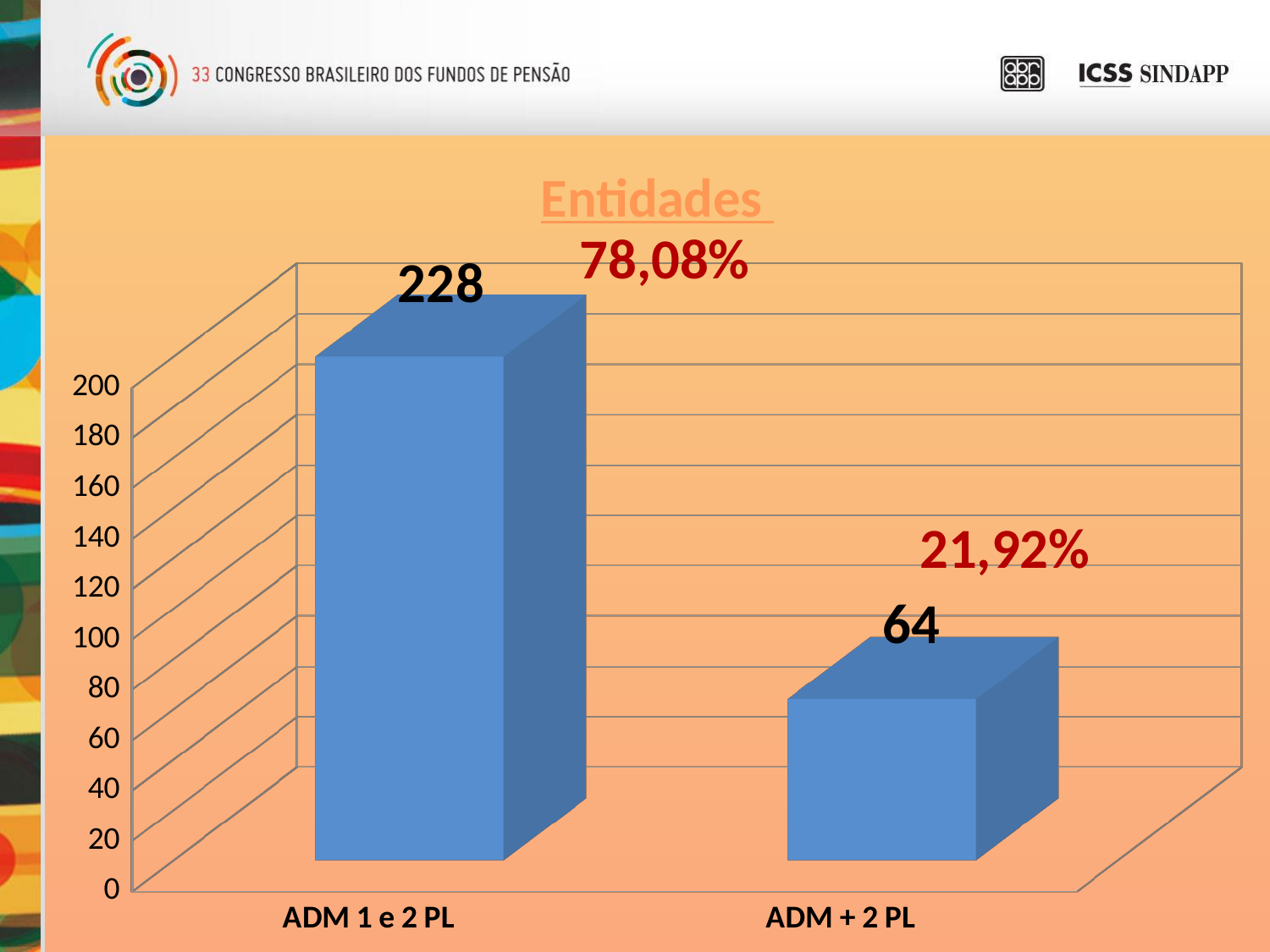
What is the value for ADM 1 e 2 PL? 228 Which category has the highest value? ADM 1 e 2 PL How many categories are shown on the x axis? 2 What is the difference between the values for ADM 1 e 2 PL and ADM + 2 PL? 164 What is the value for ADM + 2 PL? 64 Which category has the lowest value? ADM + 2 PL Which is larger, the value for ADM 1 e 2 PL or the value for ADM + 2 PL? ADM 1 e 2 PL Is the value for ADM + 2 PL greater or less than 100? less What percentage is shown in red above the ADM + 2 PL bar? 21,92% What is the title of the chart? Entidades What is the total of the two bar values? 292 What kind of chart is shown on the slide? bar chart